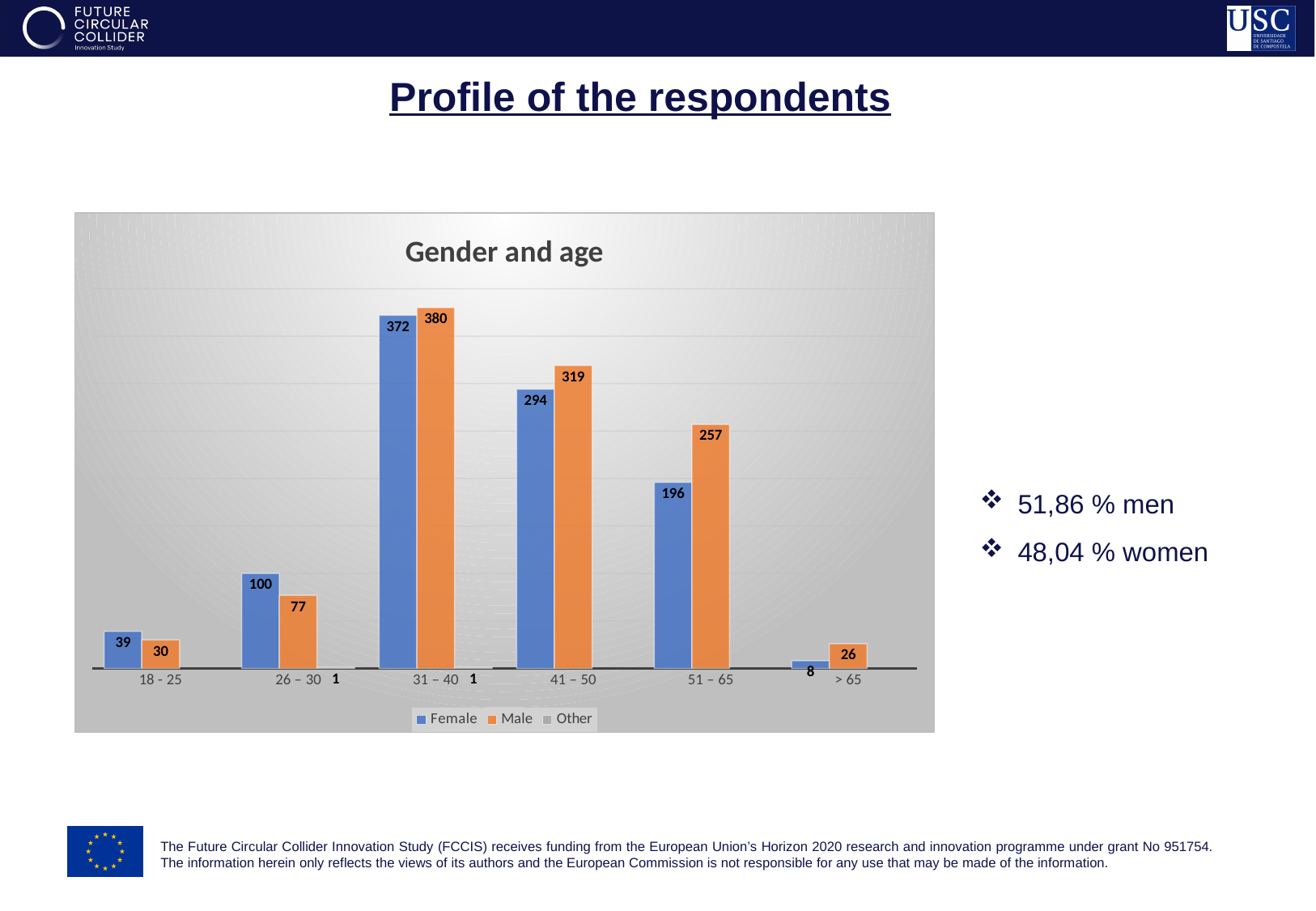
What is the Other value for the 26 – 30 age group? 1 How many age categories are shown on the x axis? 6 What is the Female value for the > 65 age group? 8 Which is larger for the 26 – 30 age group, the Female value or the Male value? Female Which age group has the highest Male value? 31 – 40 What is the difference between the Male and Female values for the 41 – 50 age group? 25 Which age group has the lowest Female value? > 65 What type of chart is shown on the slide? Bar chart What is the Female value for the 31 – 40 age group? 372 What is the title of the chart? Gender and age What is the Male value for the 51 – 65 age group? 257 How many series does the legend list? 3